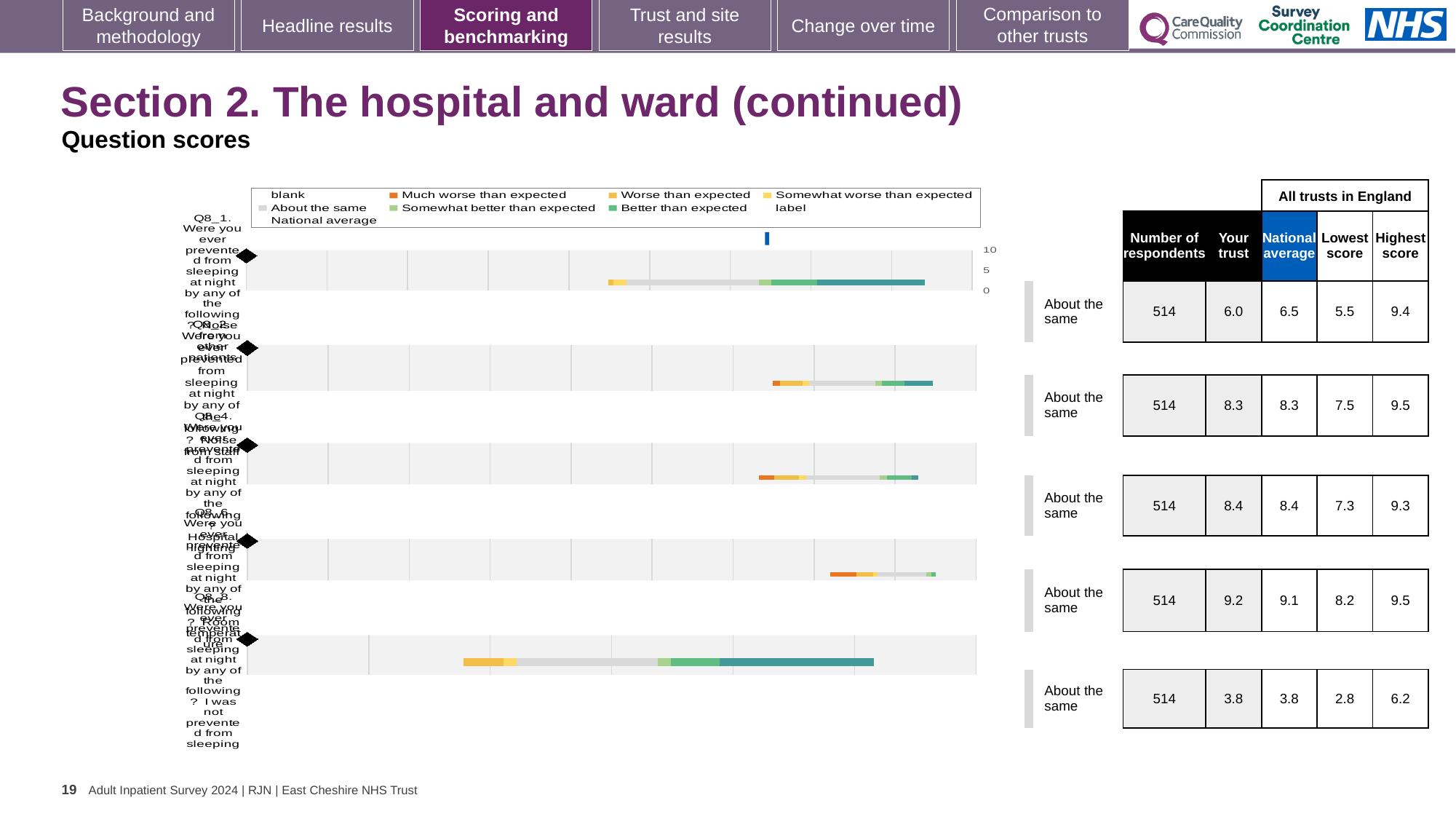
What benchmark label is shown beside each bar in the chart? About the same What kind of chart is shown on the slide? bar chart How many question rows (bars) are plotted in the chart? 5 How many entries does the chart legend list? 9 Which bar row has the highest 'Your trust' score in the table beside the chart? Q8_6 Which bar row has the lowest 'Your trust' score in the table beside the chart? Q8_8 For the fourth bar (Q8_6), is the 'Your trust' score (9.2) larger or smaller than the national average (9.1)? larger Which legend entry is shown in dark orange? Much worse than expected In the table beside the chart, what is the 'Your trust' score for the first bar (Q8_1)? 6.0 For the first bar (Q8_1), what is the difference between the national average (6.5) and the trust score (6.0) shown in the table? 0.5 How many respondents are listed for each bar row in the table beside the chart? 514 In the table beside the chart, what is the 'Your trust' score for the last bar (Q8_8)? 3.8